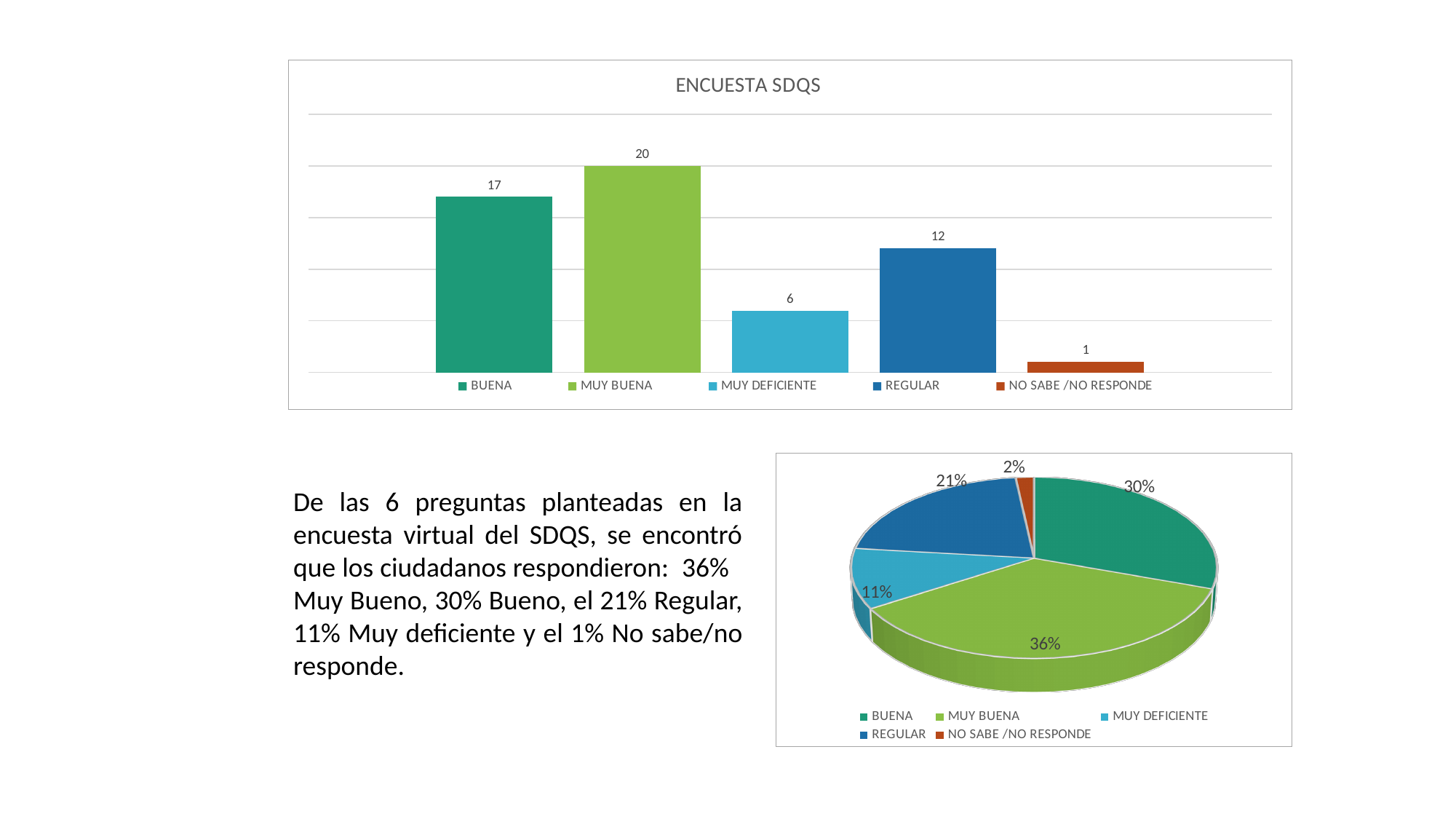
In the bar chart titled ENCUESTA SDQS, how many categories are plotted? 5 In the pie chart at the bottom right, what share does NO SABE /NO RESPONDE have? 2% In the bar chart titled ENCUESTA SDQS, what is the value for REGULAR? 12 How many entries does the legend of the pie chart at the bottom right list? 5 In the bar chart titled ENCUESTA SDQS, which is larger, the value for MUY DEFICIENTE or the value for REGULAR? REGULAR In the bar chart titled ENCUESTA SDQS, which category has the lowest value? NO SABE /NO RESPONDE In the bar chart titled ENCUESTA SDQS, what is the value for MUY BUENA? 20 In the pie chart at the bottom right, what share does MUY BUENA have? 36% What kind of chart is the chart titled ENCUESTA SDQS at the top of the slide? bar chart In the pie chart at the bottom right, which slice is the largest? MUY BUENA In the bar chart titled ENCUESTA SDQS, which category has the highest value? MUY BUENA In the bar chart titled ENCUESTA SDQS, what is the difference between the values for MUY BUENA and BUENA? 3